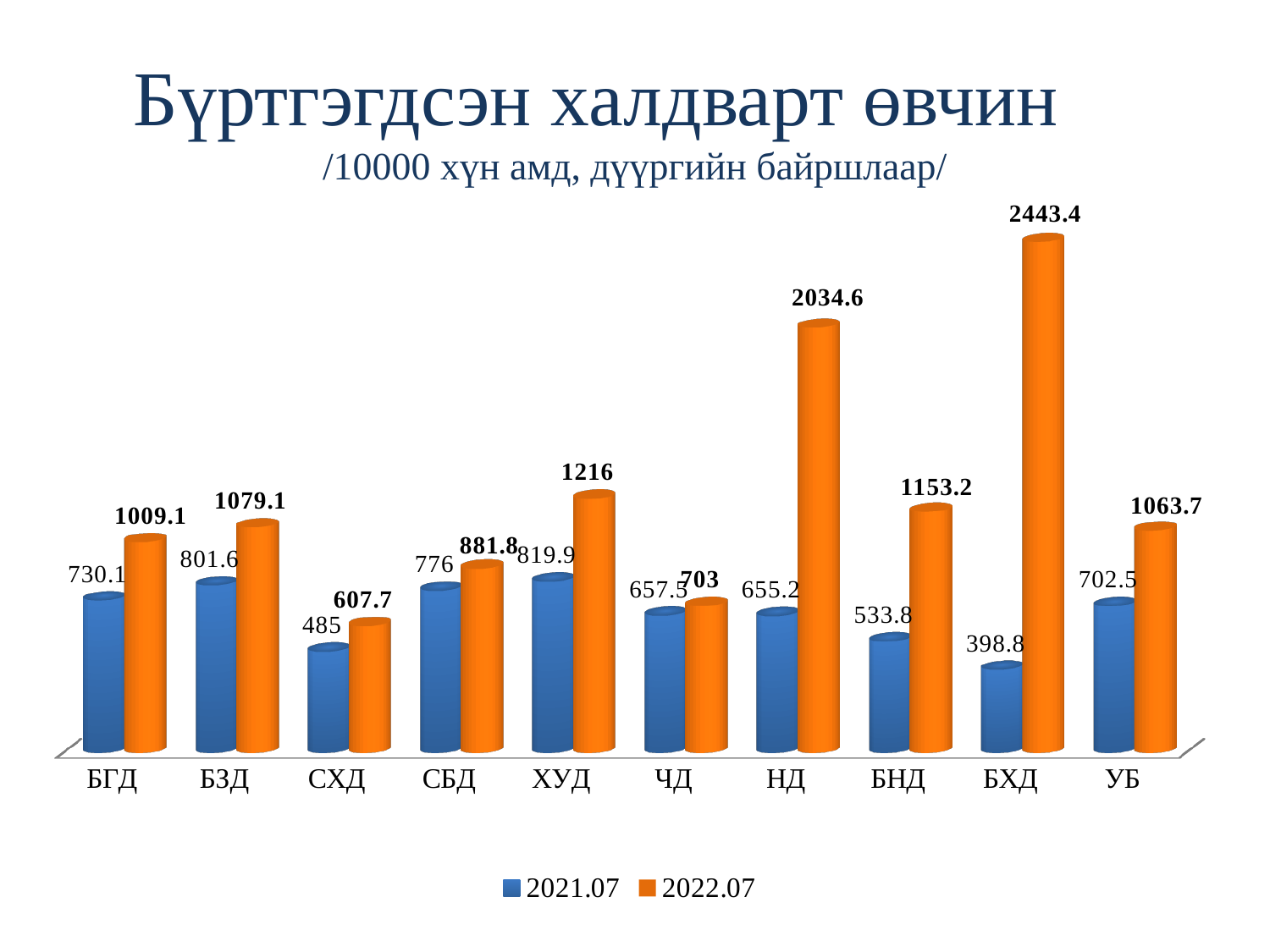
Which is larger, the 2022.07 value for НД or the 2022.07 value for БНД? НД What is the 2022.07 value for ХУД? 1216 What is the difference between the 2022.07 and 2021.07 values for БГД? 279 What is the difference between the 2022.07 and 2021.07 values for БХД? 2044.6 How many districts are shown on the x axis? 10 What is the 2022.07 value for БХД? 2443.4 Which district has the lowest 2021.07 value? БХД Which district has the highest 2022.07 value? БХД How many series does the legend list? 2 Which district has the highest 2021.07 value? ХУД What kind of chart is shown on the slide? Bar chart What is the 2021.07 value for СХД? 485